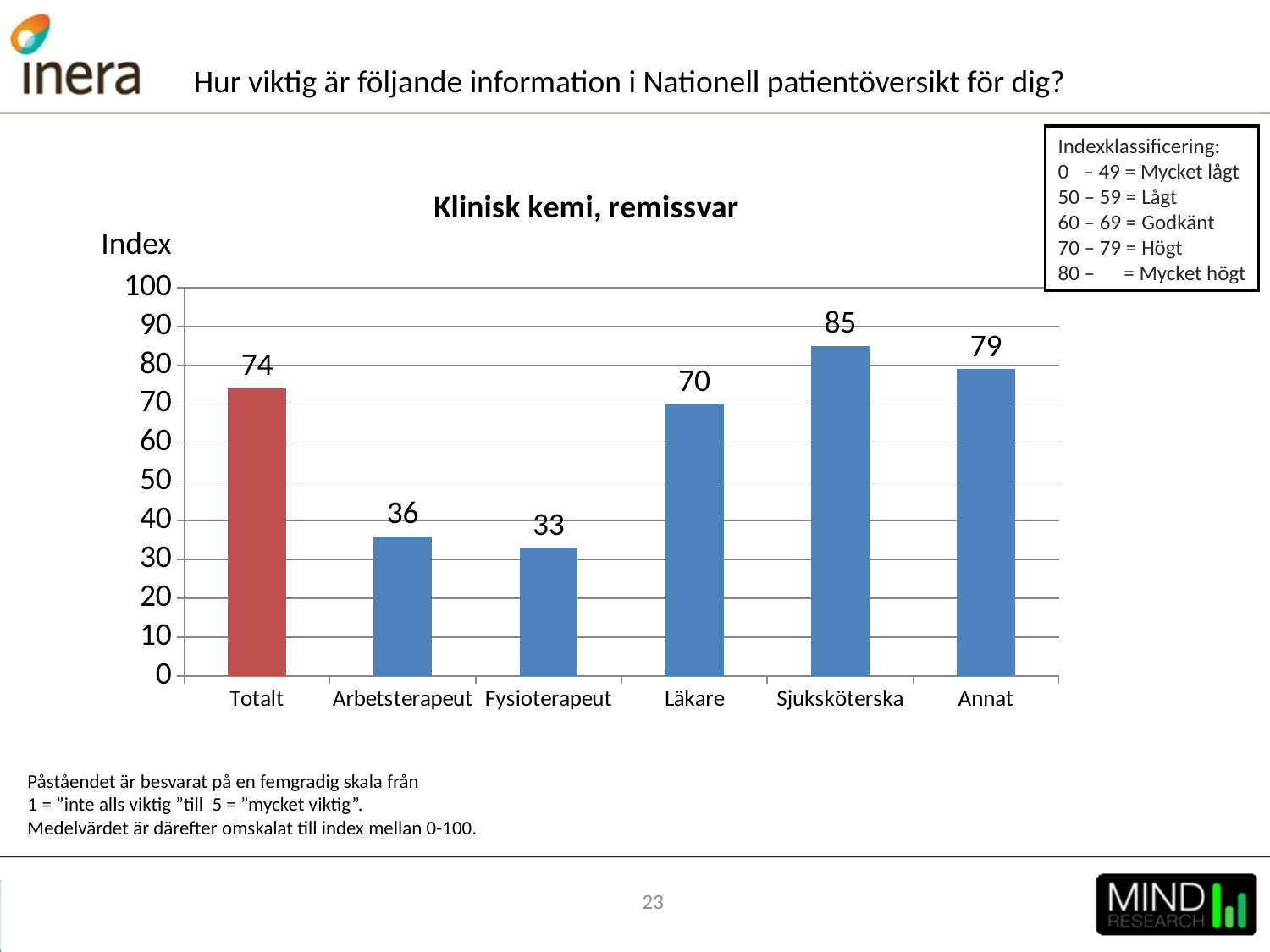
What is the index value for Totalt? 74 What is the difference between the index values for Sjuksköterska and Läkare? 15 What is the difference between the index values for Arbetsterapeut and Fysioterapeut? 3 What is the title of the chart? Klinisk kemi, remissvar Is the value for Arbetsterapeut greater or less than 50? less Which has a higher index value, Annat or Läkare? Annat What is the index value for Fysioterapeut? 33 What kind of chart is shown on the slide? bar chart Which category has the highest index value? Sjuksköterska How many categories are shown on the x axis? 6 What is the index value for Sjuksköterska? 85 Which category has the lowest index value? Fysioterapeut